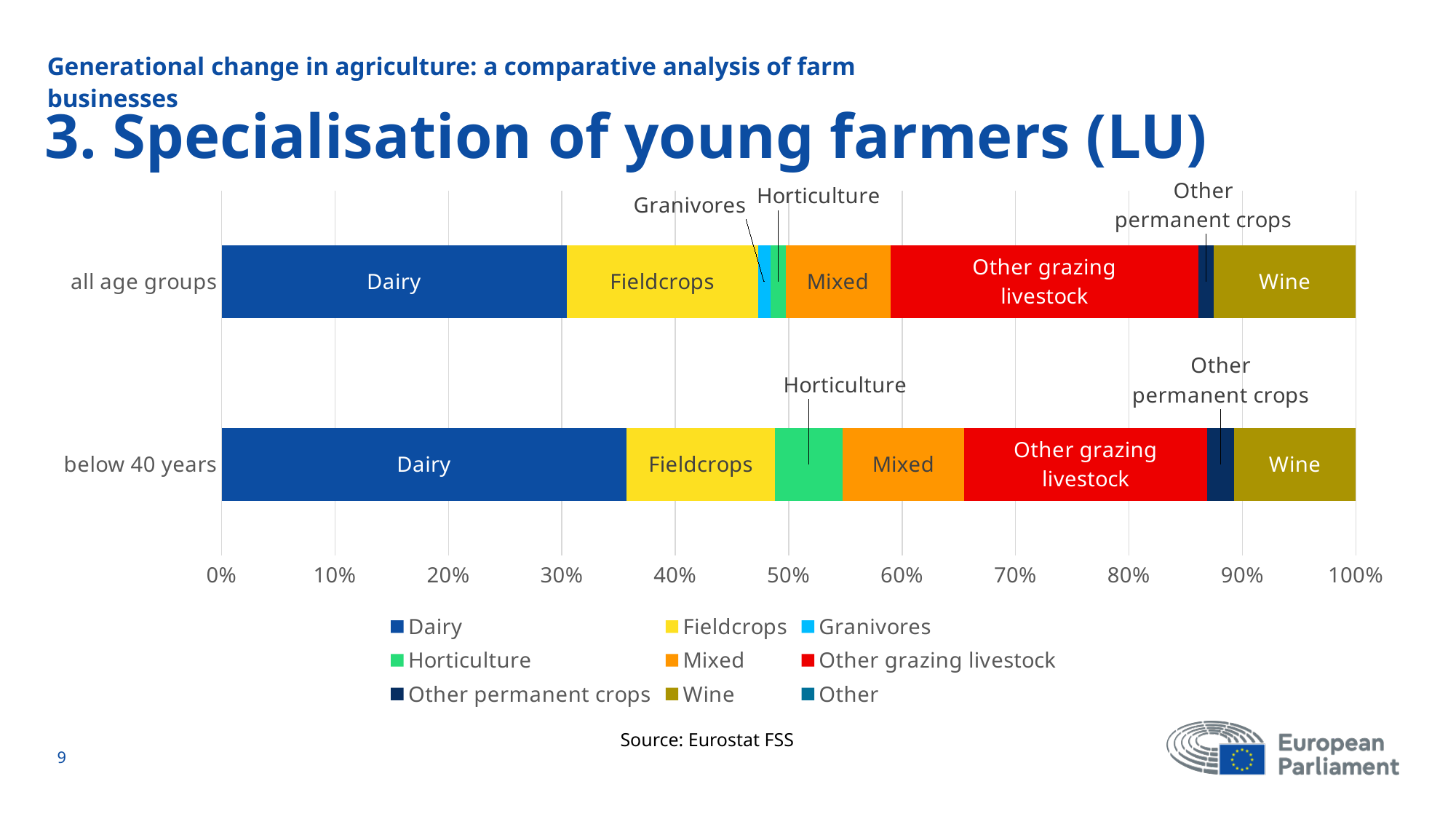
Is the Dairy share for 'all age groups' greater or less than 40%? less Is the Dairy share for 'below 40 years' larger or smaller than the Dairy share for 'all age groups'? larger Is the Dairy share for 'below 40 years' greater or less than 30%? greater Which specialisation has the largest segment in the 'below 40 years' bar? Dairy How many age-group categories are plotted on the chart? 2 What kind of chart is shown on the slide? Stacked bar chart How many series does the chart legend list? 9 Is the 'Other grazing livestock' share for 'all age groups' greater or less than 20%? greater What is the total of each stacked bar on the chart? 100% Is the Horticulture share for 'below 40 years' larger or smaller than the Horticulture share for 'all age groups'? larger What source is cited below the chart? Eurostat FSS Which specialisation has the largest segment in the 'all age groups' bar? Dairy